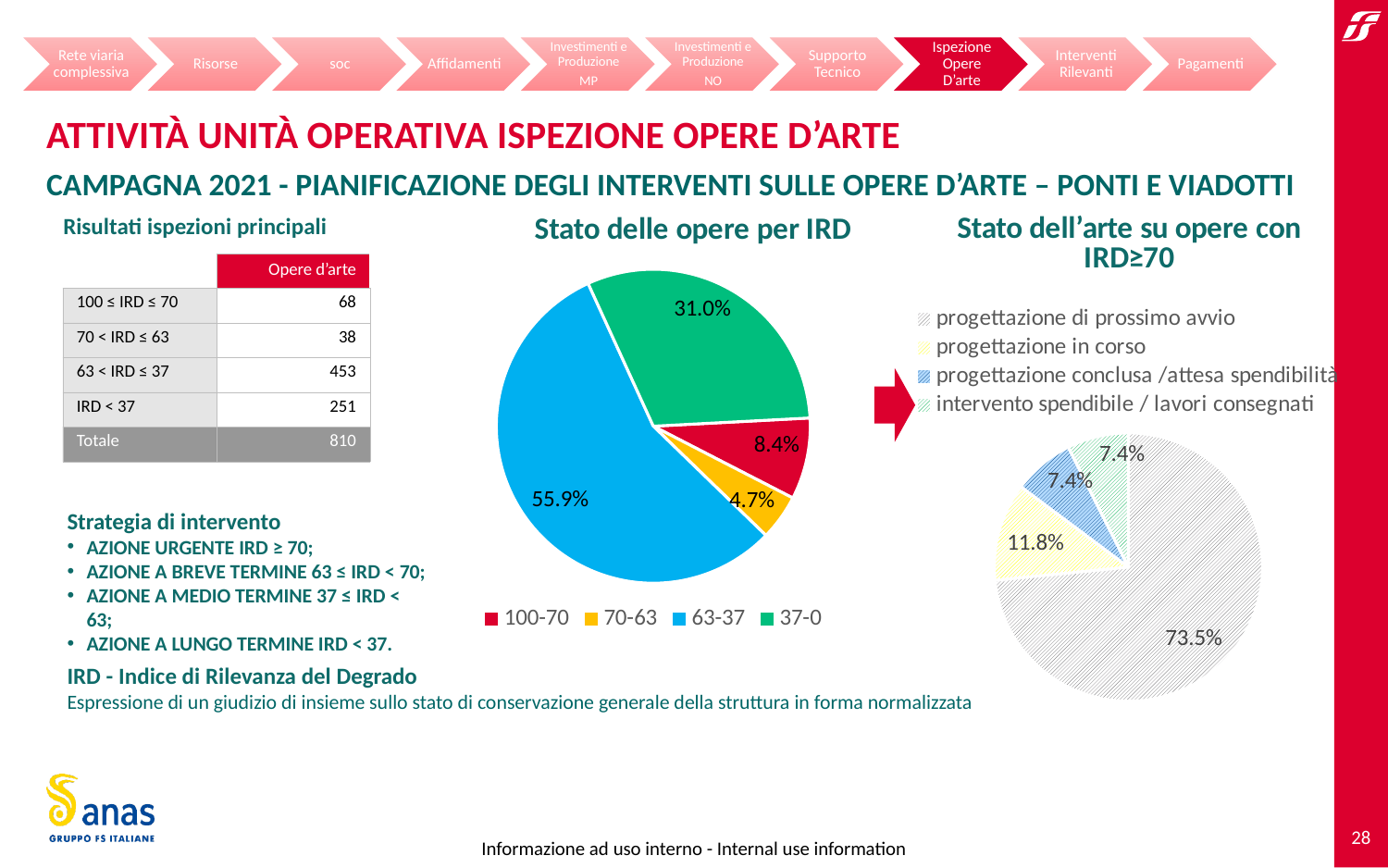
In the 'Stato delle opere per IRD' chart, what percentage is shown for the 100-70 category? 8.4% In the 'Stato delle opere per IRD' chart, which category has the smallest share? 70-63 How many entries does the legend of the 'Stato dell'arte su opere con IRD≥70' chart list? 4 In the 'Stato delle opere per IRD' chart, what percentage is shown for the 70-63 category? 4.7% What kind of chart is 'Stato delle opere per IRD'? Pie chart In the 'Stato dell'arte su opere con IRD≥70' chart, what is the largest percentage shown? 73.5% In the 'Stato delle opere per IRD' chart, which is larger: the 100-70 share or the 70-63 share? 100-70 In the 'Stato delle opere per IRD' chart, what percentage is shown for the 37-0 category? 31.0% In the 'Stato delle opere per IRD' chart, which category has the largest share? 63-37 In the 'Stato delle opere per IRD' chart, what is the difference between the 63-37 share and the 37-0 share? 24.9% How many categories does the legend of the 'Stato delle opere per IRD' chart list? 4 In the 'Stato delle opere per IRD' chart, what percentage is shown for the 63-37 category? 55.9%